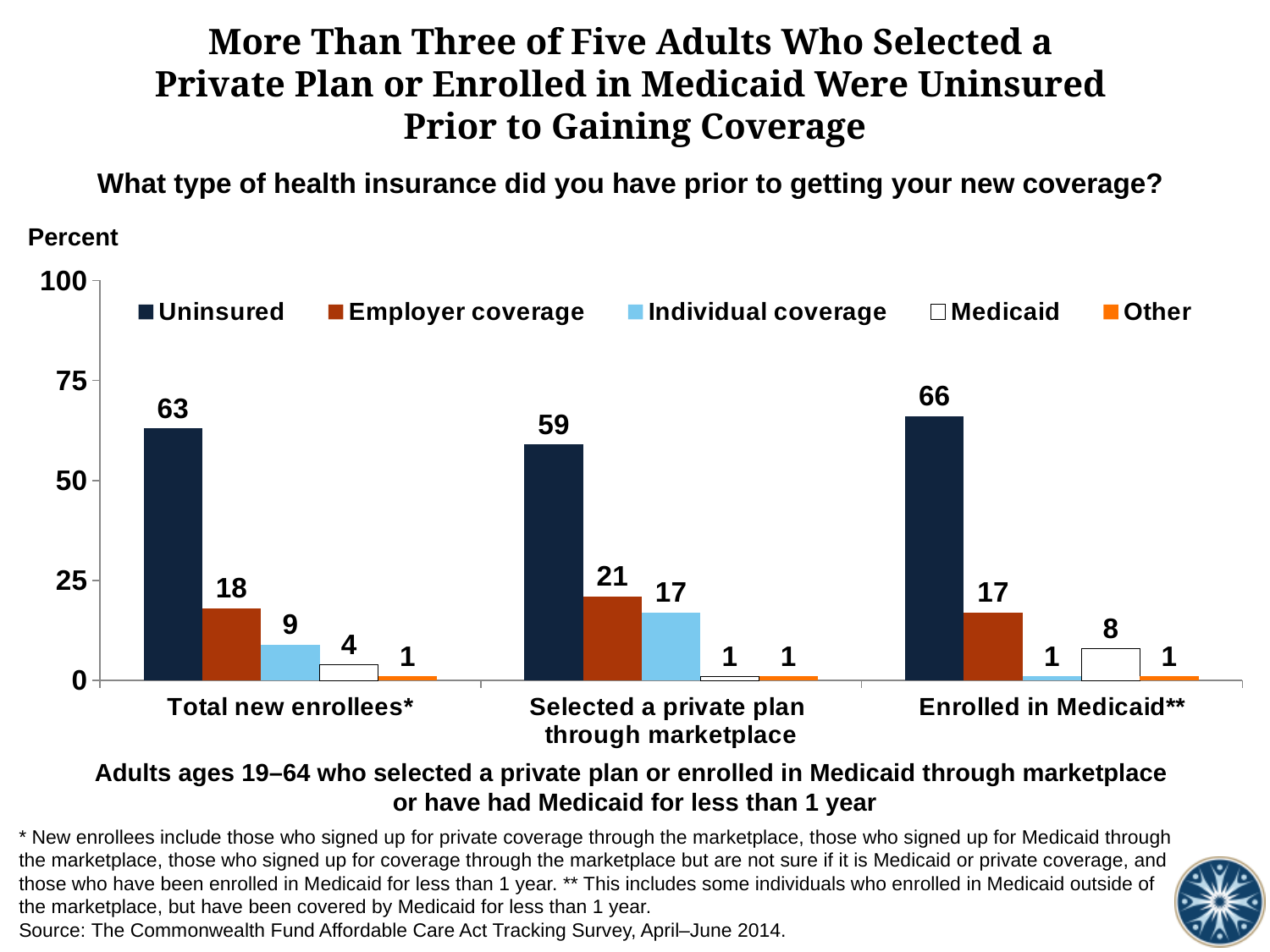
What percent of adults who selected a private plan through the marketplace had individual coverage previously? 17 Is the uninsured value for those who selected a private plan through the marketplace greater or less than 50? greater What is the label on the y axis of the chart? Percent Which group has the highest share of previously uninsured adults? Enrolled in Medicaid** How many enrollee groups are shown on the x axis? 3 What kind of chart is shown on the slide? Bar chart Which prior coverage type has the lowest value for total new enrollees? Other How many series does the legend list? 5 Which is larger for total new enrollees: the share with employer coverage or the share with individual coverage? Employer coverage What percent of total new enrollees were uninsured prior to getting their new coverage? 63 What percent of adults who enrolled in Medicaid had employer coverage previously? 17 What is the difference between the uninsured share for those enrolled in Medicaid and those who selected a private plan through the marketplace? 7